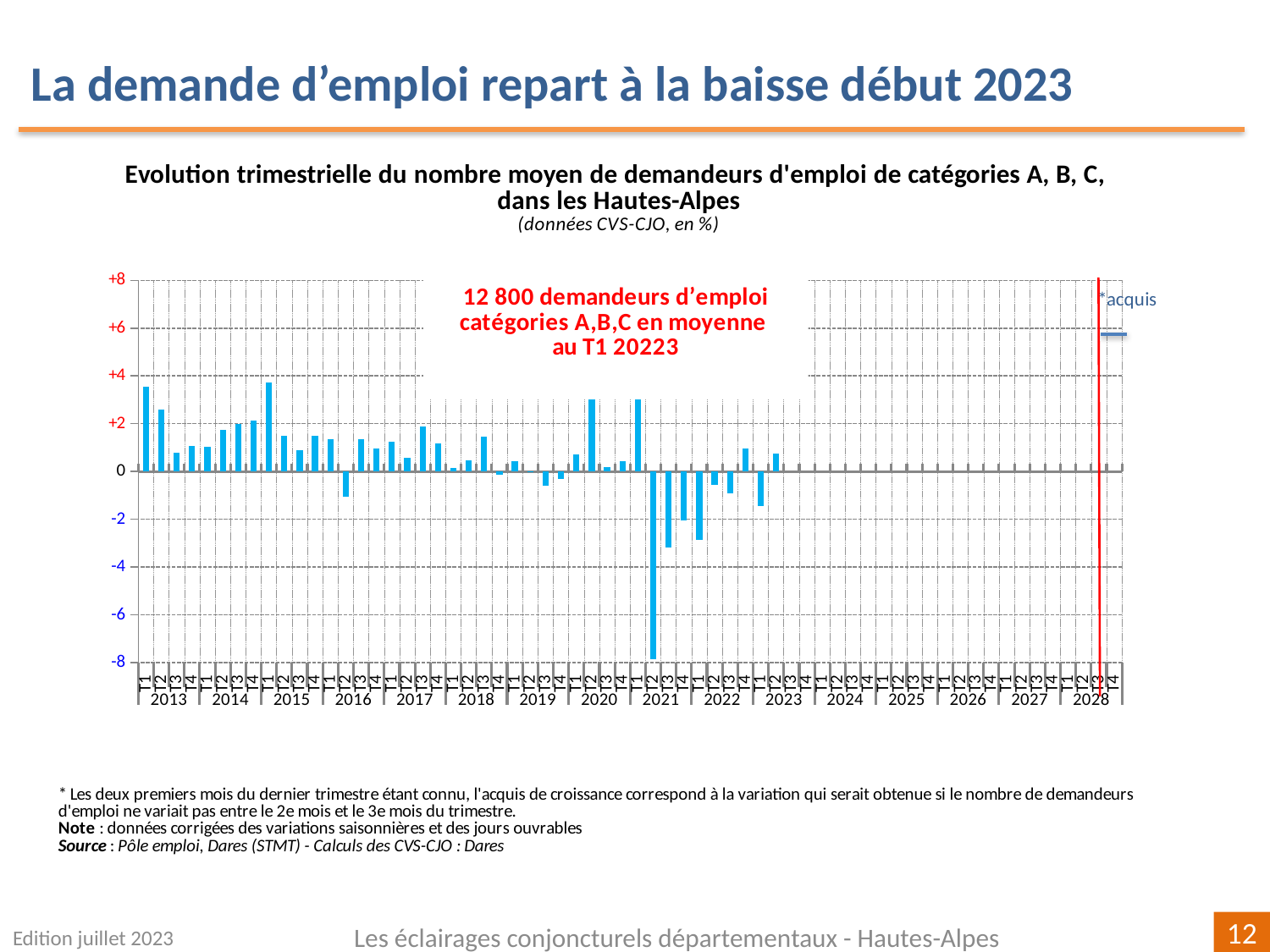
Is the value for T1 2020 greater or less than +2? less Is the value for T2 2021 greater or less than -6? less What is the title of the chart? Evolution trimestrielle du nombre moyen de demandeurs d'emploi de catégories A, B, C, dans les Hautes-Alpes Is the value for T1 2013 greater or less than +2? greater Which is larger, the value for T1 2013 or the value for T2 2021? T1 2013 Which quarter has the lowest value on the chart? T2 2021 What kind of chart is shown on the slide? bar chart According to the red annotation on the chart, how many demandeurs d'emploi catégories A,B,C were there on average au T1 2023? 12 800 Which is larger, the value for T3 2021 or the value for T1 2020? T1 2020 How many years are labelled along the x axis of the chart? 16